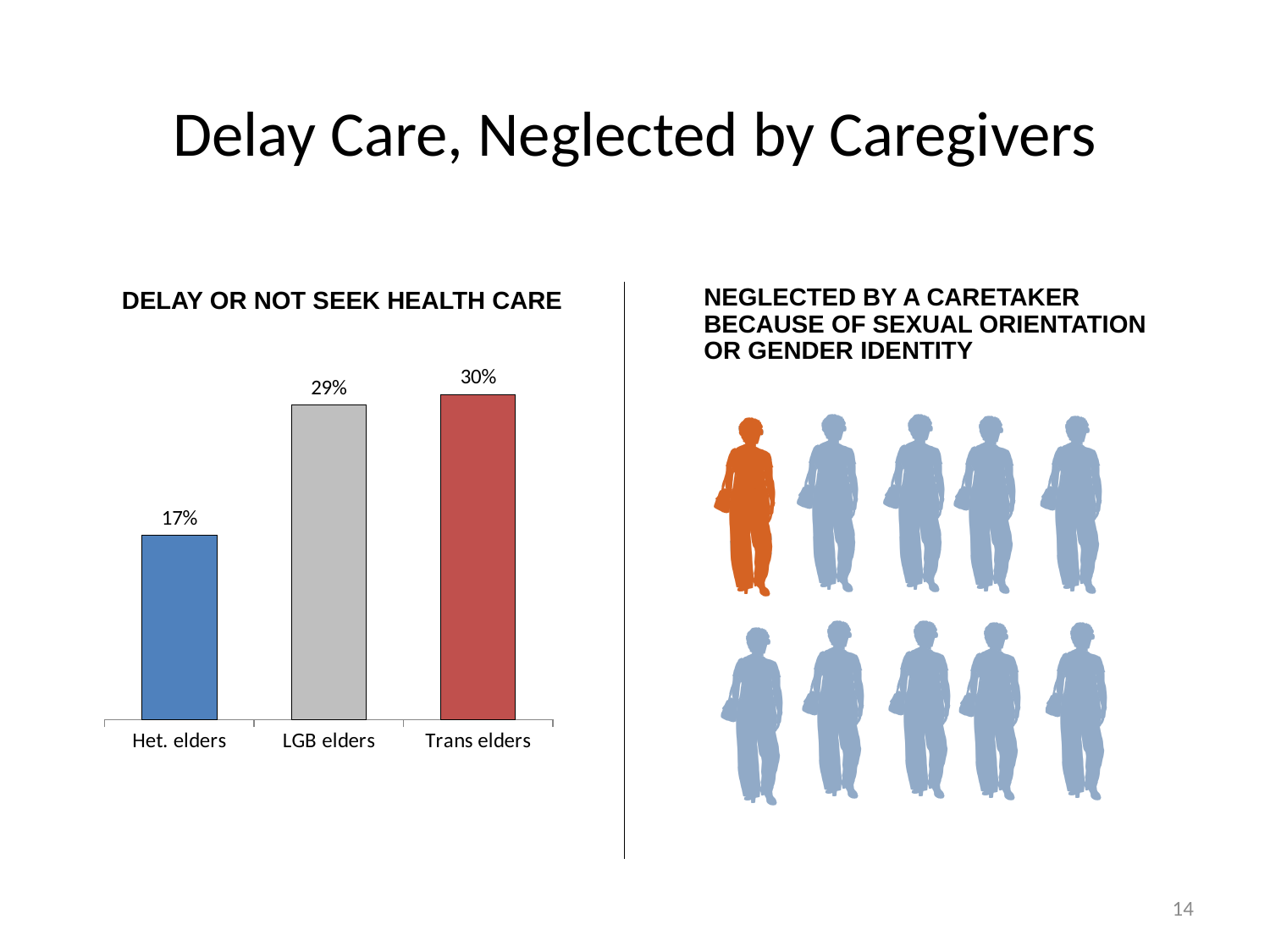
How many categories are shown in the 'Delay or not seek health care' chart? 3 What colour is the Het. elders bar in the 'Delay or not seek health care' chart? Blue In the 'Delay or not seek health care' chart, which category has the highest value? Trans elders What kind of chart is the 'Delay or not seek health care' chart? Bar chart In the 'Delay or not seek health care' chart, what is the value for Trans elders? 30% In the 'Delay or not seek health care' chart, which is larger, the value for LGB elders or for Het. elders? LGB elders In the 'Delay or not seek health care' chart, what is the difference between the values for Trans elders and Het. elders? 13% In the 'Delay or not seek health care' chart, what is the value for Het. elders? 17% In the 'Delay or not seek health care' chart, what is the difference between the values for LGB elders and Het. elders? 12% In the 'Delay or not seek health care' chart, which category has the lowest value? Het. elders In the 'Delay or not seek health care' chart, what is the value for LGB elders? 29% In the 'Neglected by a caretaker' graphic on the right, how many of the ten figures are highlighted in orange? 1